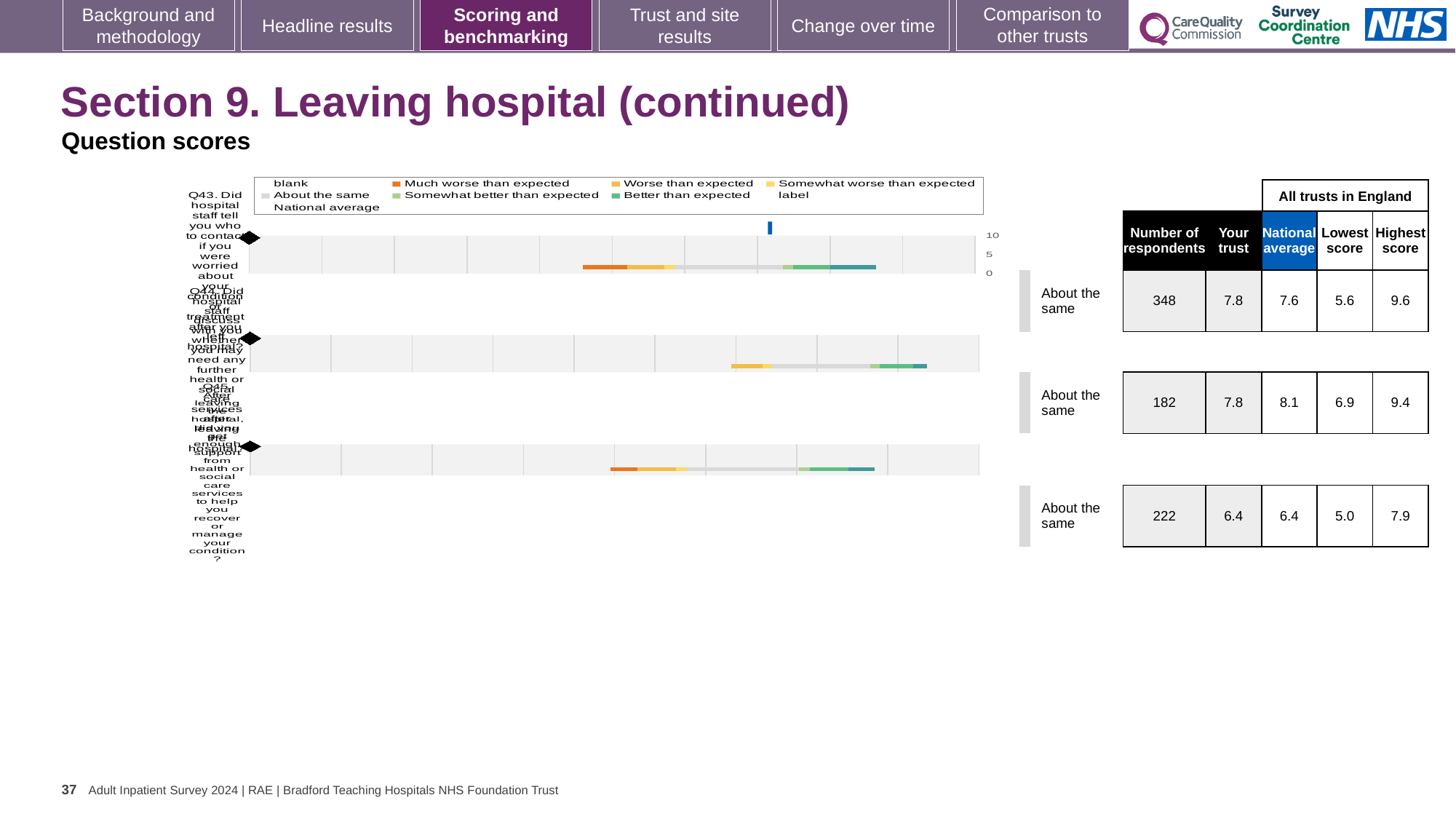
What benchmark rating label is shown next to each of the three question rows? About the same In the table beside the chart, what is the number of respondents for the first question row (Q43)? 348 In the table beside the chart, what is the 'Your trust' score for the first question row (Q43)? 7.8 What kind of chart is shown on the slide? bar chart In the table beside the chart, for the second question row, which is larger: the 'Your trust' score or the national average? National average In the table beside the chart, which question row has the largest number of respondents? the first row (Q43), 348 How many question rows are plotted in the chart? 3 In the table beside the chart, what is the highest score for the third question row? 7.9 What is the highest value shown on the chart's numeric axis? 10 In the table beside the chart, what is the national average for the second question row? 8.1 In the table beside the chart, what is the difference between the highest score and the lowest score for the first question row (Q43)? 4.0 Which legend entry is shown in orange in the chart's legend? Much worse than expected